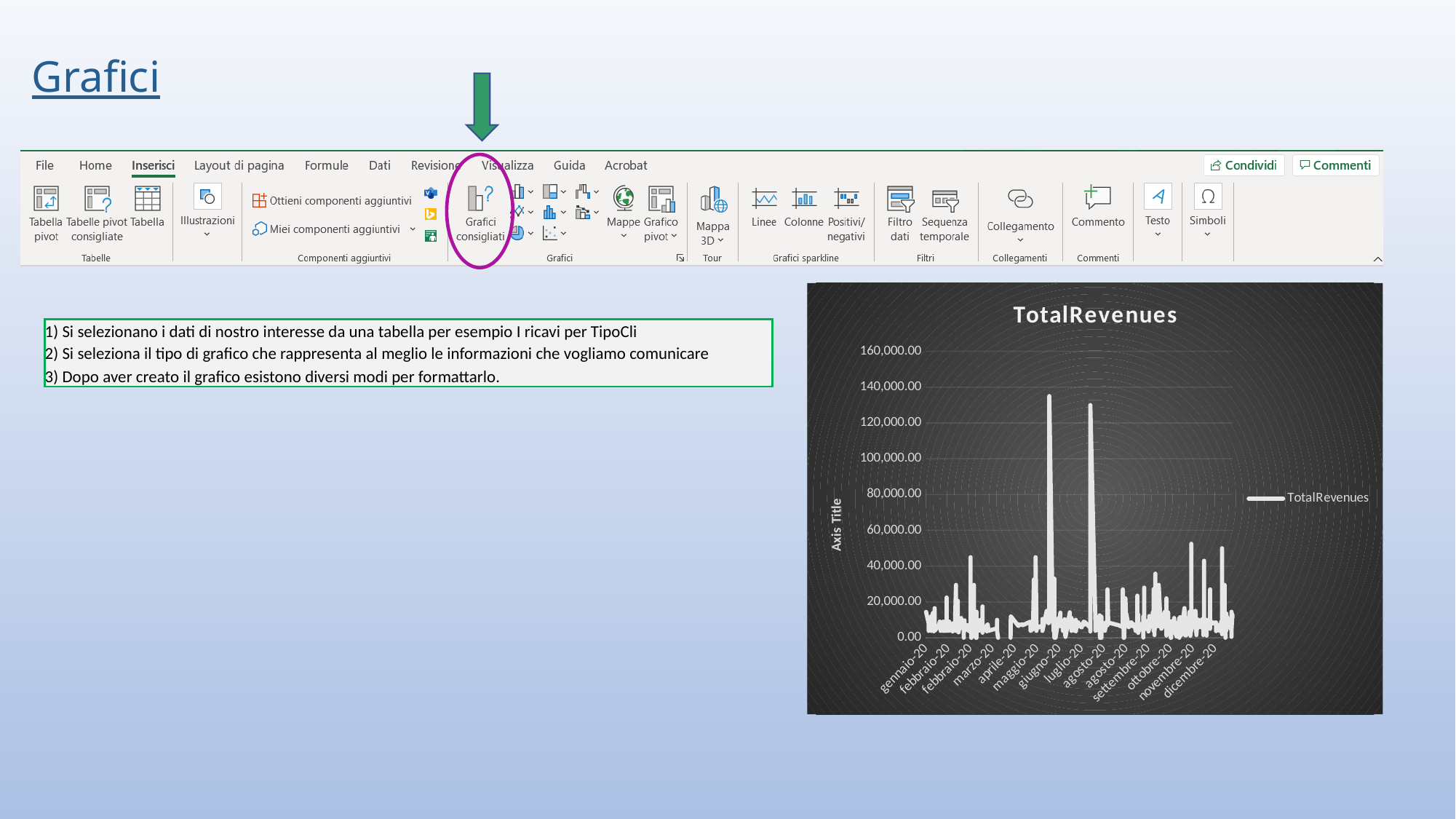
Which month label on the x axis is closest to the tallest spike of the line? giugno-20 Is the highest peak of the TotalRevenues line greater or less than 140,000.00? less Is the value of the TotalRevenues line at dicembre-20 greater or less than 60,000.00? less What is the name of the series shown in the legend? TotalRevenues Does the TotalRevenues line ever reach 160,000.00? No What is the highest value shown on the vertical axis? 160,000.00 What is the title of the chart? TotalRevenues How many series does the chart's legend list? 1 What kind of chart is shown on the slide? line chart